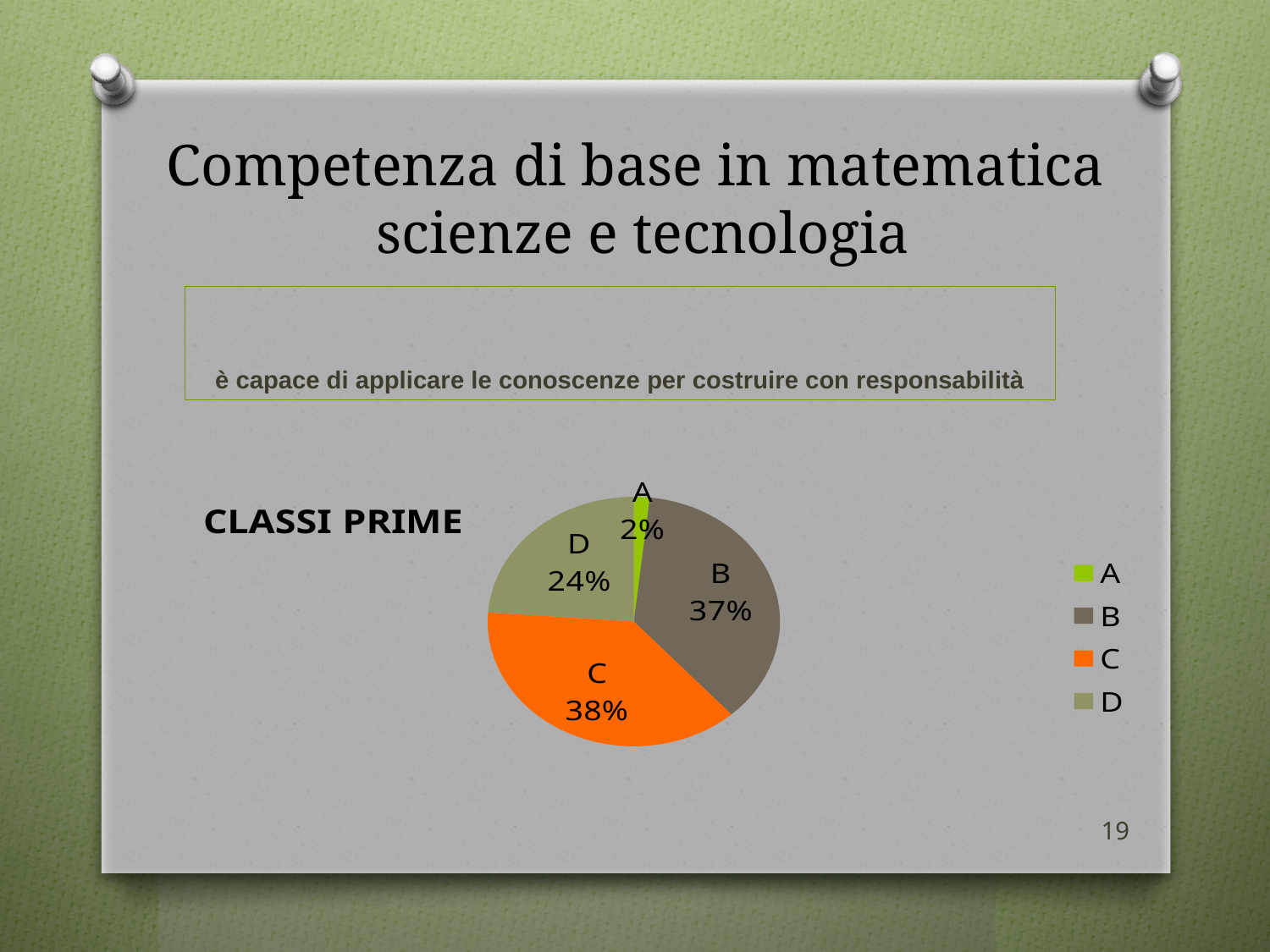
What share of the pie does slice A represent? 2% What is the difference in percentage points between slice D and slice A? 22 Which is larger, slice B or slice D? B Which slice of the pie is the smallest? A What share of the pie does slice D represent? 24% What is the combined share of slices B and C? 75% What share of the pie does slice B represent? 37% How many slices does the pie chart have? 4 How many entries does the legend list? 4 What kind of chart is shown on the slide? pie chart What colour is slice C in the pie chart? orange